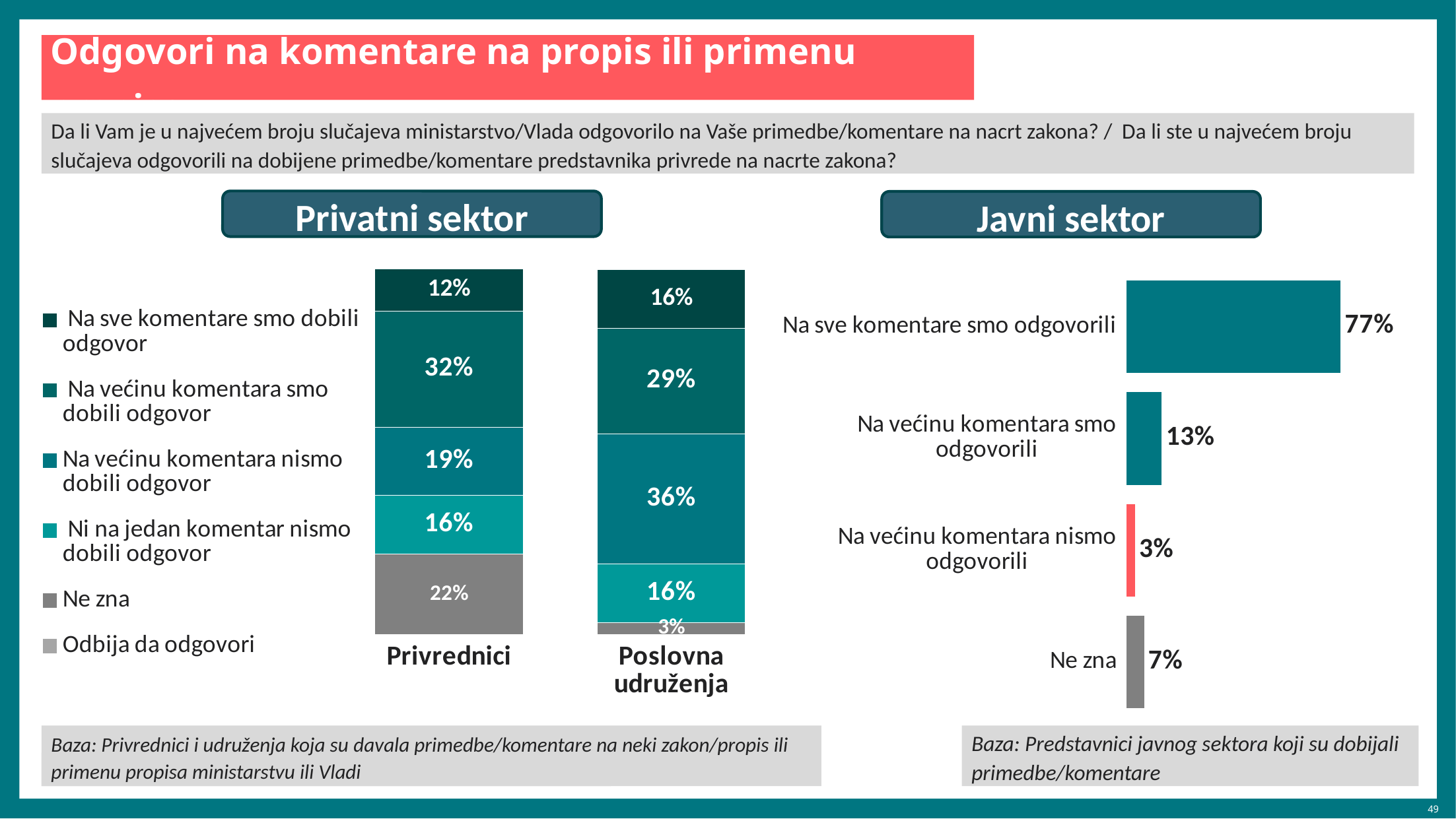
What kind of chart is the Privatni sektor chart? Stacked bar chart In the Javni sektor chart, what is the value for 'Na sve komentare smo odgovorili'? 77% How many categories are shown in the Javni sektor chart? 4 In the Privatni sektor chart, what percentage of Privrednici said 'Na većinu komentara smo dobili odgovor'? 32% In the Javni sektor chart, which category has the lowest value? Na većinu komentara nismo odgovorili In the Privatni sektor chart, what is the difference between the 'Na sve komentare smo dobili odgovor' values for Poslovna udruženja and Privrednici? 4 percentage points In the Privatni sektor chart, what is the 'Ne zna' value for Poslovna udruženja? 3% In the Privatni sektor chart, what is the 'Ne zna' value for Privrednici? 22% In the Privatni sektor chart, which group has the larger 'Na većinu komentara nismo dobili odgovor' share, Privrednici or Poslovna udruženja? Poslovna udruženja How many entries does the legend of the Privatni sektor chart list? 6 In the Privatni sektor chart, what percentage of Poslovna udruženja said 'Na većinu komentara nismo dobili odgovor'? 36% In the Javni sektor chart, what is the difference between 'Na većinu komentara smo odgovorili' and 'Ne zna'? 6 percentage points